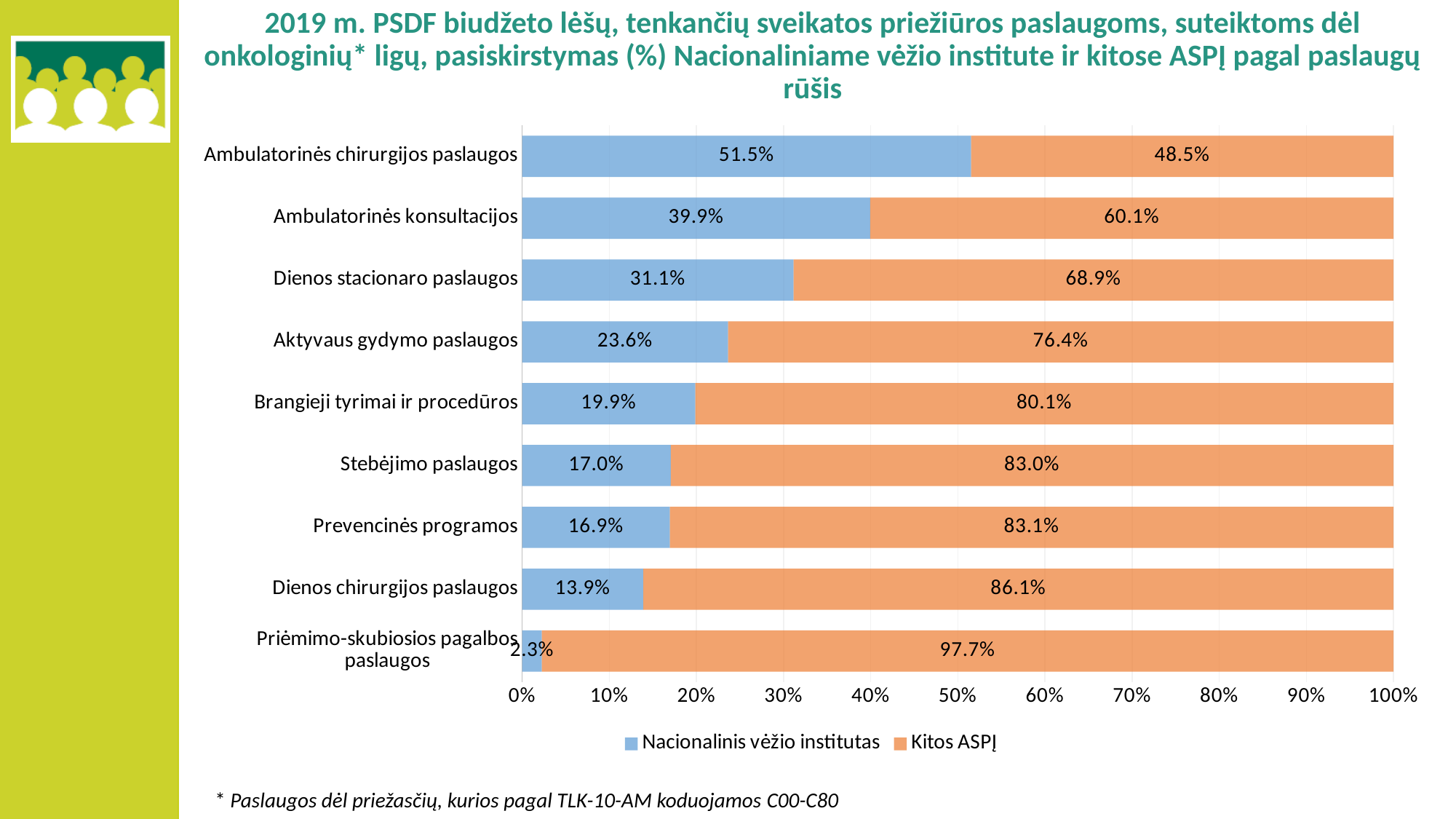
What is the total of the stacked bar for Stebėjimo paslaugos? 100.0% How many service categories are shown on the chart? 9 Which category has the lowest value for Kitos ASPĮ? Ambulatorinės chirurgijos paslaugos What is the value for Kitos ASPĮ for Dienos stacionaro paslaugos? 68.9% Which category has the highest value for Nacionalinis vėžio institutas? Ambulatorinės chirurgijos paslaugos What is the value for Nacionalinis vėžio institutas for Ambulatorinės chirurgijos paslaugos? 51.5% Is the Nacionalinis vėžio institutas value for Brangieji tyrimai ir procedūros greater or less than 30%? less How many series does the legend list? 2 Which is larger: the Nacionalinis vėžio institutas value for Ambulatorinės konsultacijos or for Dienos stacionaro paslaugos? Ambulatorinės konsultacijos What is the difference between the Kitos ASPĮ and Nacionalinis vėžio institutas values for Aktyvaus gydymo paslaugos? 52.8% What is the value for Nacionalinis vėžio institutas for Priėmimo-skubiosios pagalbos paslaugos? 2.3% What kind of chart is shown on the slide? Stacked bar chart